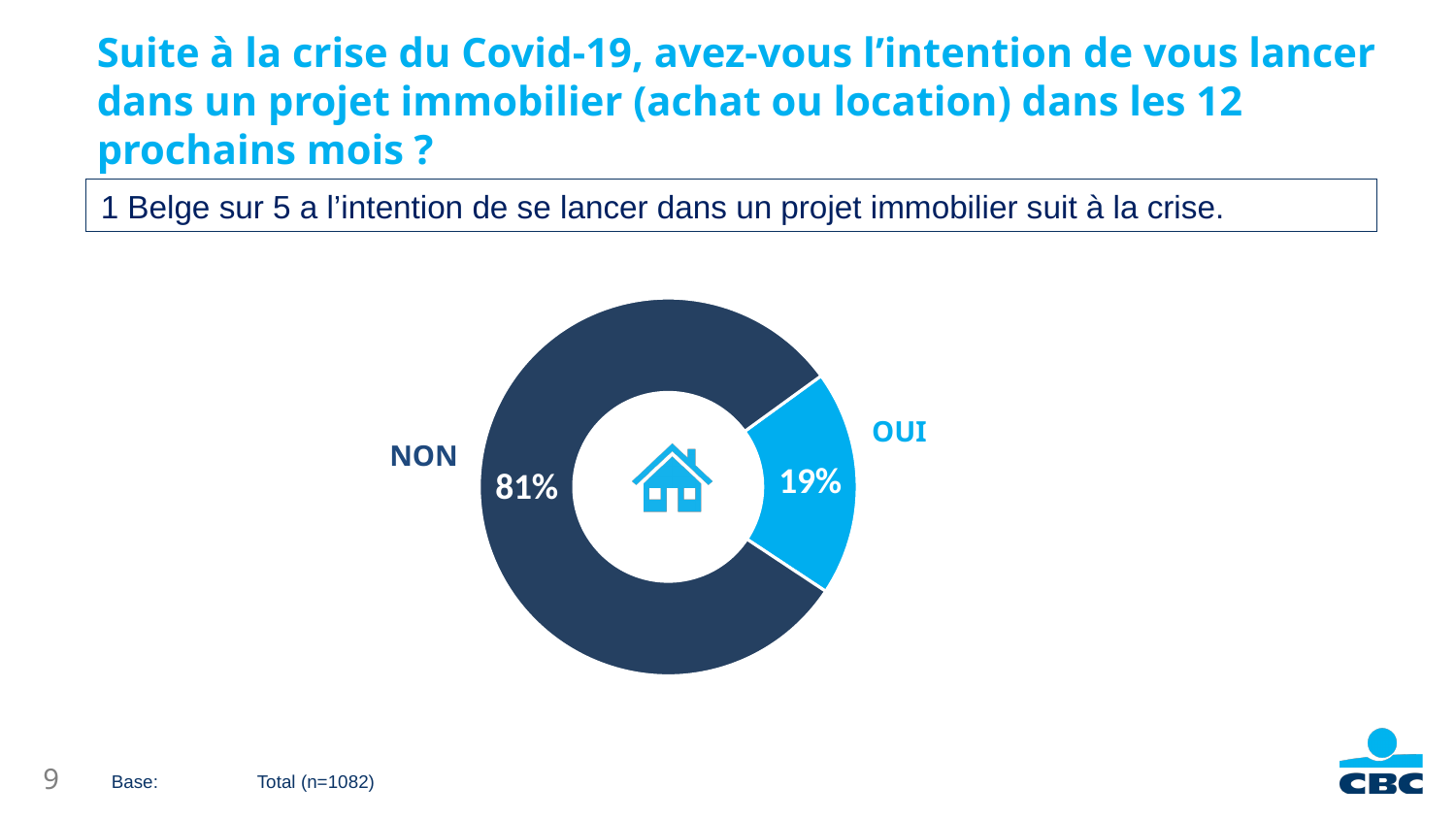
What percentage of respondents answered OUI? 19% What share of the pie does the OUI slice represent? 19% Which answer has the smallest share of the chart? OUI What kind of chart is shown on the slide? Pie chart (doughnut) What is the base (sample size) stated for the chart? Total (n=1082) Which answer has the largest share of the chart? NON How many categories does the chart show? 2 What is the total of the two slices shown in the chart? 100% Which is larger, the share for OUI or the share for NON? NON What is the difference in percentage points between NON and OUI? 62 What percentage of respondents answered NON? 81% Which colour is used for the OUI slice? Light blue